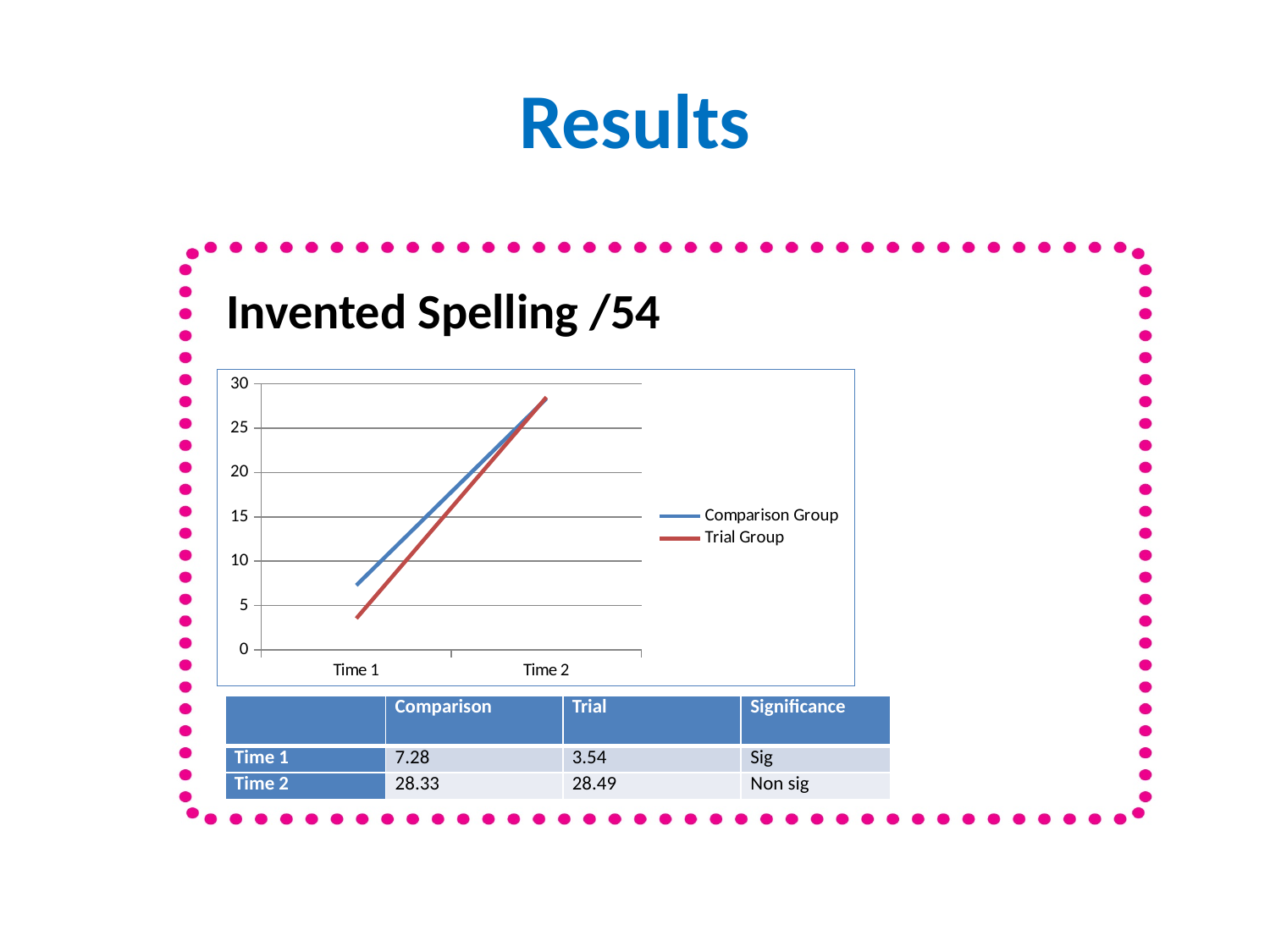
Do the values for the Trial Group rise or fall from Time 1 to Time 2? rise What is the difference between the Comparison Group and Trial Group values at Time 1? 3.74 What is the value for the Trial Group at Time 2? 28.49 Is the value for the Comparison Group at Time 2 greater or less than 25? greater What type of chart is shown on the slide? line chart What is the value for the Trial Group at Time 1? 3.54 Is the value for the Trial Group at Time 1 greater or less than 5? less How many time points are plotted on the x axis of the chart? 2 What is the value for the Comparison Group at Time 1? 7.28 At Time 1, which group has the higher value, the Comparison Group or the Trial Group? Comparison Group What is the value for the Comparison Group at Time 2? 28.33 How many series does the chart legend list? 2